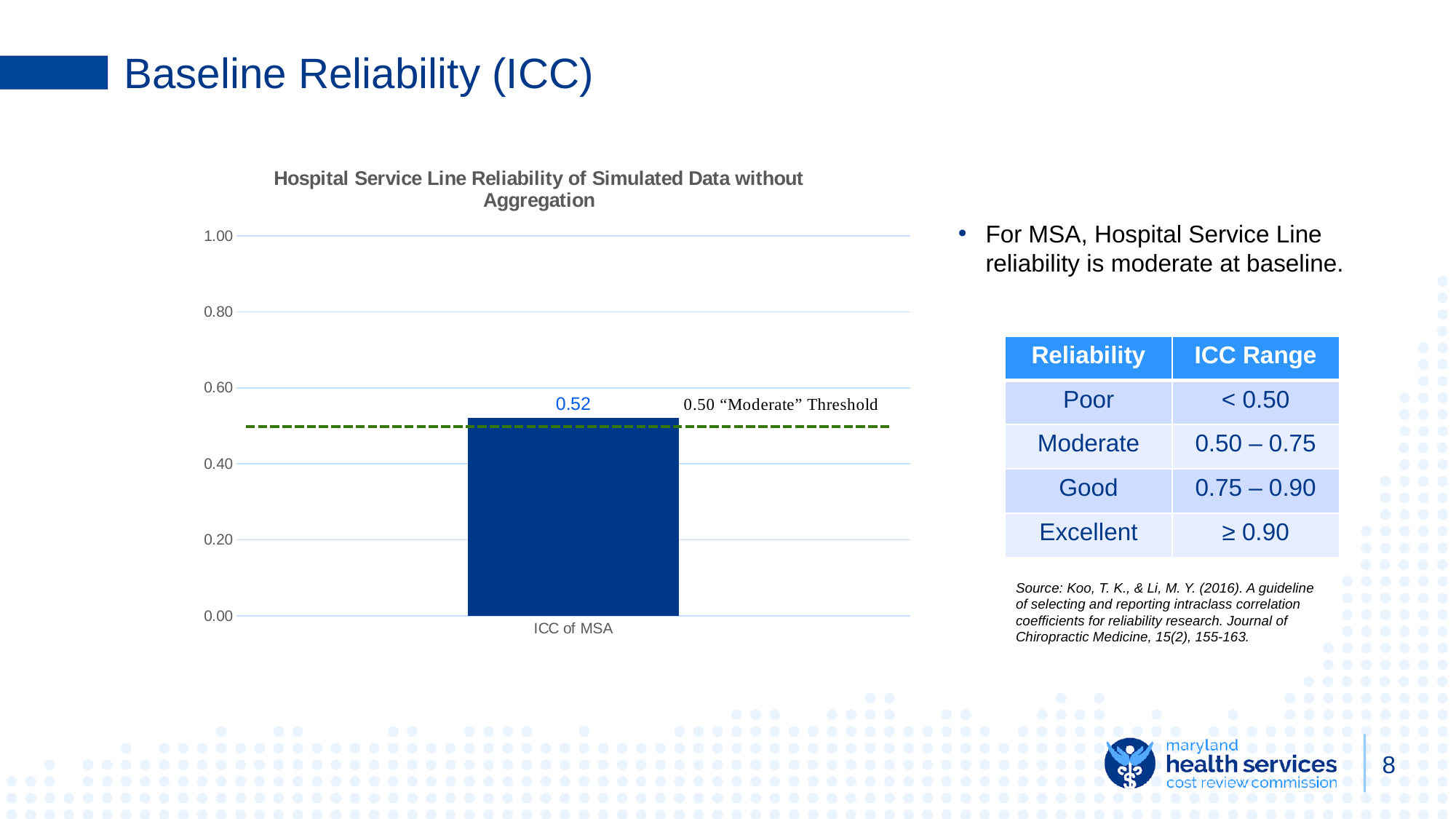
What is the category label on the x axis of the chart? ICC of MSA What threshold value does the dashed line in the chart mark? 0.50 Is the value for ICC of MSA greater or less than 0.60? less What kind of chart is shown on the slide? bar chart Is the ICC of MSA bar above or below the 0.50 "Moderate" Threshold line? above What is the maximum value shown on the chart's y axis? 1.00 What is the value of the ICC of MSA bar? 0.52 How many bars are plotted in the chart? 1 Is the value for ICC of MSA greater or less than 0.40? greater What is the title of the chart? Hospital Service Line Reliability of Simulated Data without Aggregation